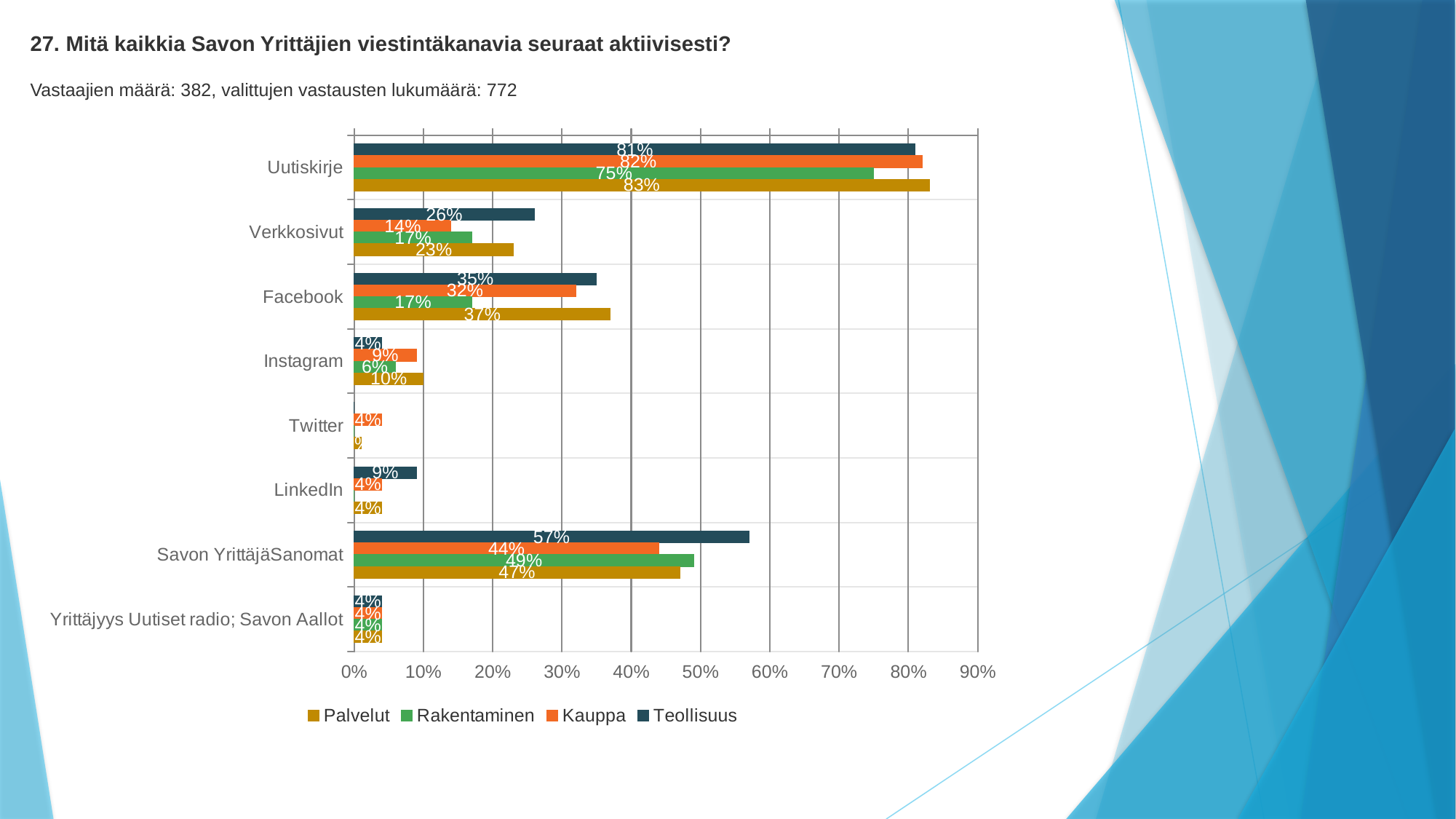
How many series does the legend list? 4 What is the value for Palvelut in the Uutiskirje category? 83% What is the value for Teollisuus in the Savon YrittäjäSanomat category? 57% What is the value for Rakentaminen in the Facebook category? 17% What is the value for Kauppa in the Verkkosivut category? 14% Which series has the highest value in the Facebook category? Palvelut What kind of chart is shown on the slide? Bar chart Which series has the lowest value in the Uutiskirje category? Rakentaminen How many categories are shown on the chart? 8 Which is larger in the Verkkosivut category: Teollisuus or Palvelut? Teollisuus What is the difference between the Teollisuus and Kauppa values in the Savon YrittäjäSanomat category? 13% Is the value for Kauppa in the Facebook category greater or less than 20%? greater